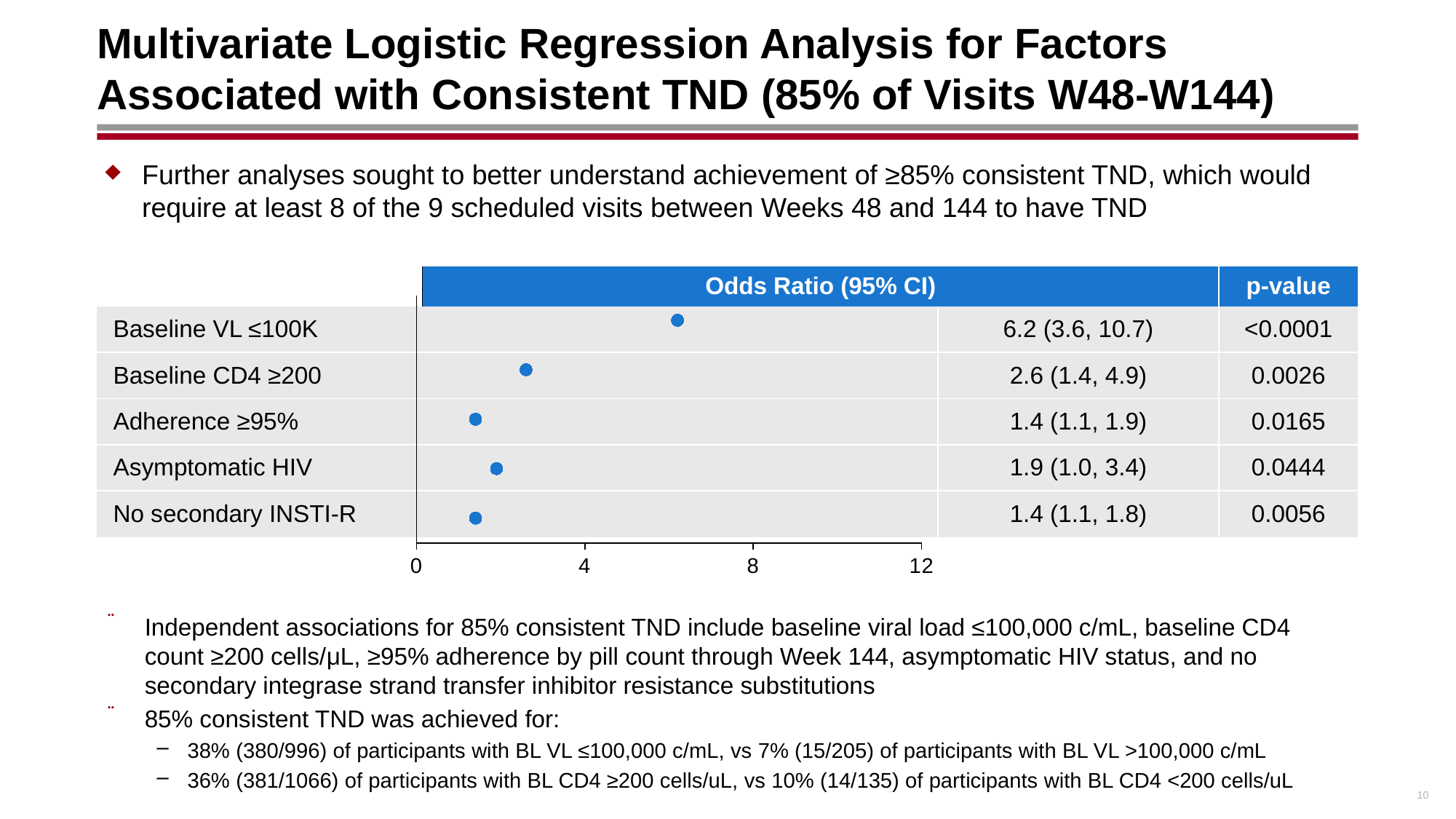
What is the difference between the odds ratios for Baseline VL ≤100K and Baseline CD4 ≥200? 3.6 What is the highest tick value shown on the x axis? 12 What is the p-value for Adherence ≥95%? 0.0165 What is the odds ratio for Baseline CD4 ≥200? 2.6 What is the 95% confidence interval shown for Baseline VL ≤100K? (3.6, 10.7) Which has a larger odds ratio, Baseline CD4 ≥200 or Asymptomatic HIV? Baseline CD4 ≥200 What is the odds ratio for Asymptomatic HIV? 1.9 What is the odds ratio for Baseline VL ≤100K? 6.2 How many factors are plotted in the chart? 5 Which factor has the highest odds ratio? Baseline VL ≤100K Is the odds ratio for Baseline VL ≤100K greater or less than 4? greater What kind of chart is used to display the odds ratios? Dot plot (forest plot)